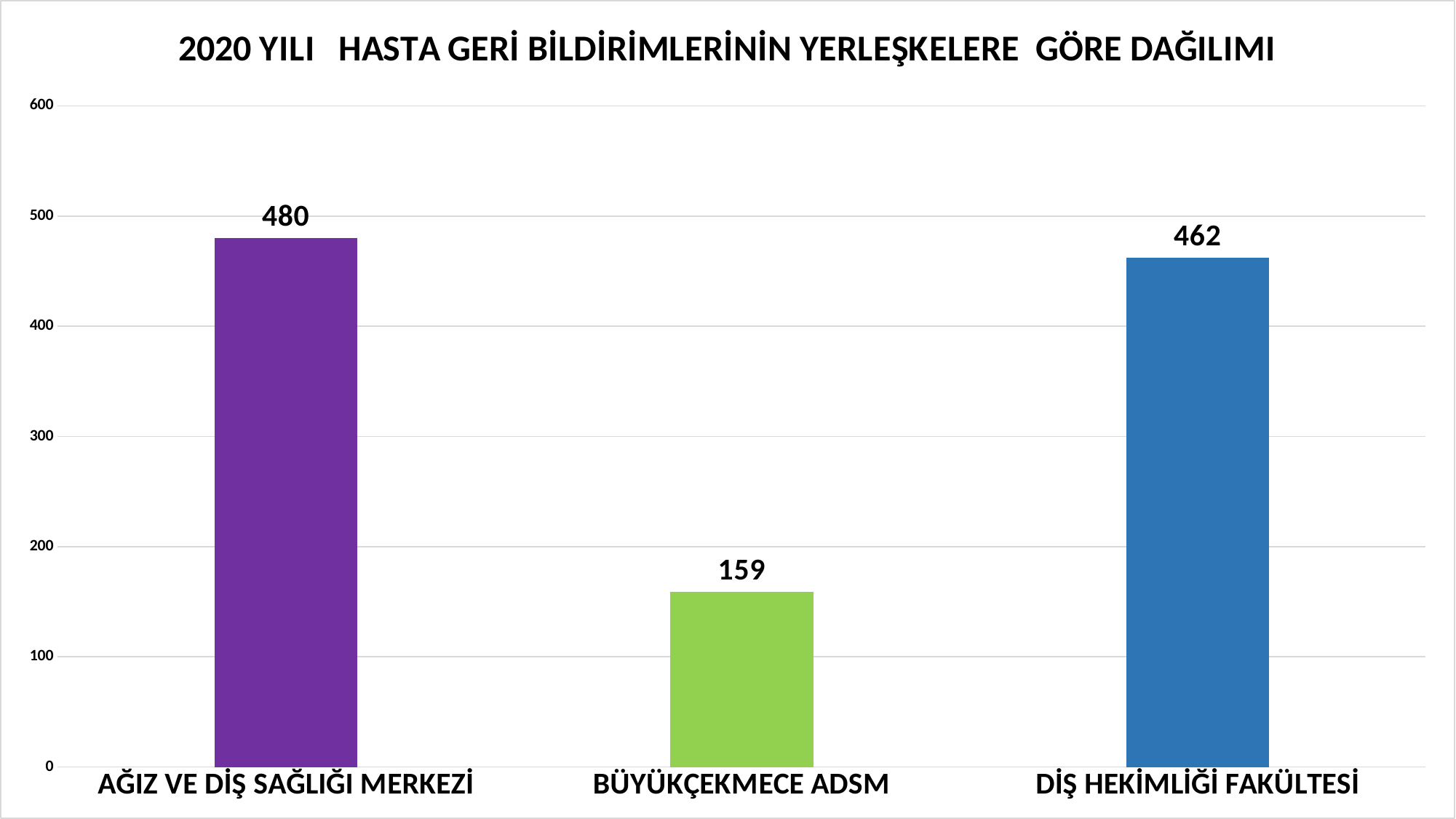
What is the title of the chart? 2020 YILI HASTA GERİ BİLDİRİMLERİNİN YERLEŞKELERE GÖRE DAĞILIMI What is the difference between the values for DİŞ HEKİMLİĞİ FAKÜLTESİ and BÜYÜKÇEKMECE ADSM? 303 Is the value for BÜYÜKÇEKMECE ADSM greater or less than 200? less What is the value for DİŞ HEKİMLİĞİ FAKÜLTESİ? 462 What is the value for BÜYÜKÇEKMECE ADSM? 159 What is the value for AĞIZ VE DİŞ SAĞLIĞI MERKEZİ? 480 What kind of chart is shown on the slide? bar chart Which category has the highest value? AĞIZ VE DİŞ SAĞLIĞI MERKEZİ Which is larger, the value for BÜYÜKÇEKMECE ADSM or the value for DİŞ HEKİMLİĞİ FAKÜLTESİ? DİŞ HEKİMLİĞİ FAKÜLTESİ What is the difference between the values for AĞIZ VE DİŞ SAĞLIĞI MERKEZİ and DİŞ HEKİMLİĞİ FAKÜLTESİ? 18 Which category has the lowest value? BÜYÜKÇEKMECE ADSM How many categories are shown in the chart? 3